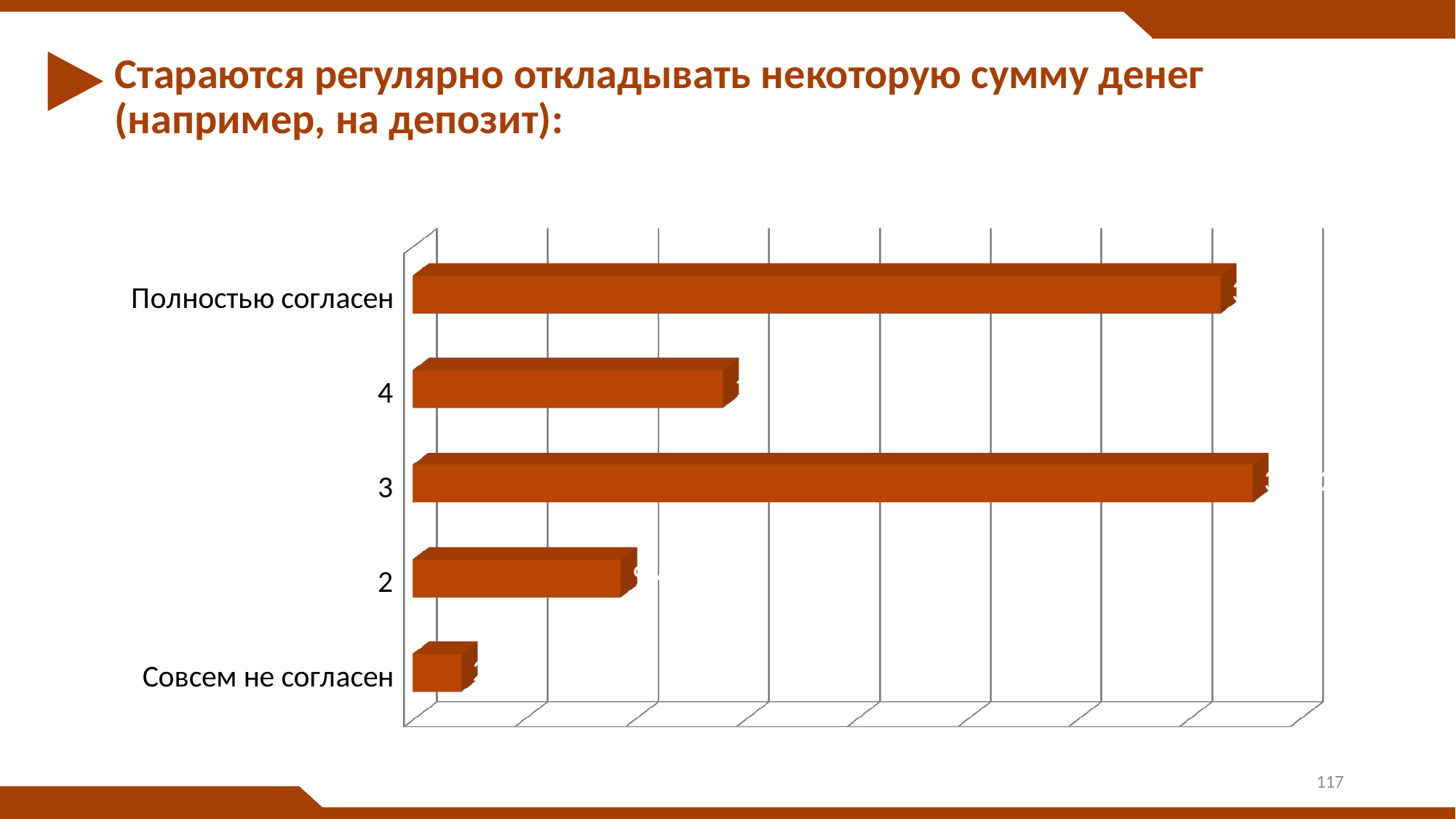
Which bar is longer: "Полностью согласен" or "4"? Полностью согласен Which bar is longer: "4" or "2"? 4 Which category has the shortest bar? Совсем не согласен Which bar is longer: "3" or "Полностью согласен"? 3 How many categories are plotted in the chart? 5 What kind of chart is shown on the slide? bar chart What is the label of the topmost category in the chart? Полностью согласен Which category has the longest bar? 3 What is the title of the slide containing the chart? Стараются регулярно откладывать некоторую сумму денег (например, на депозит):